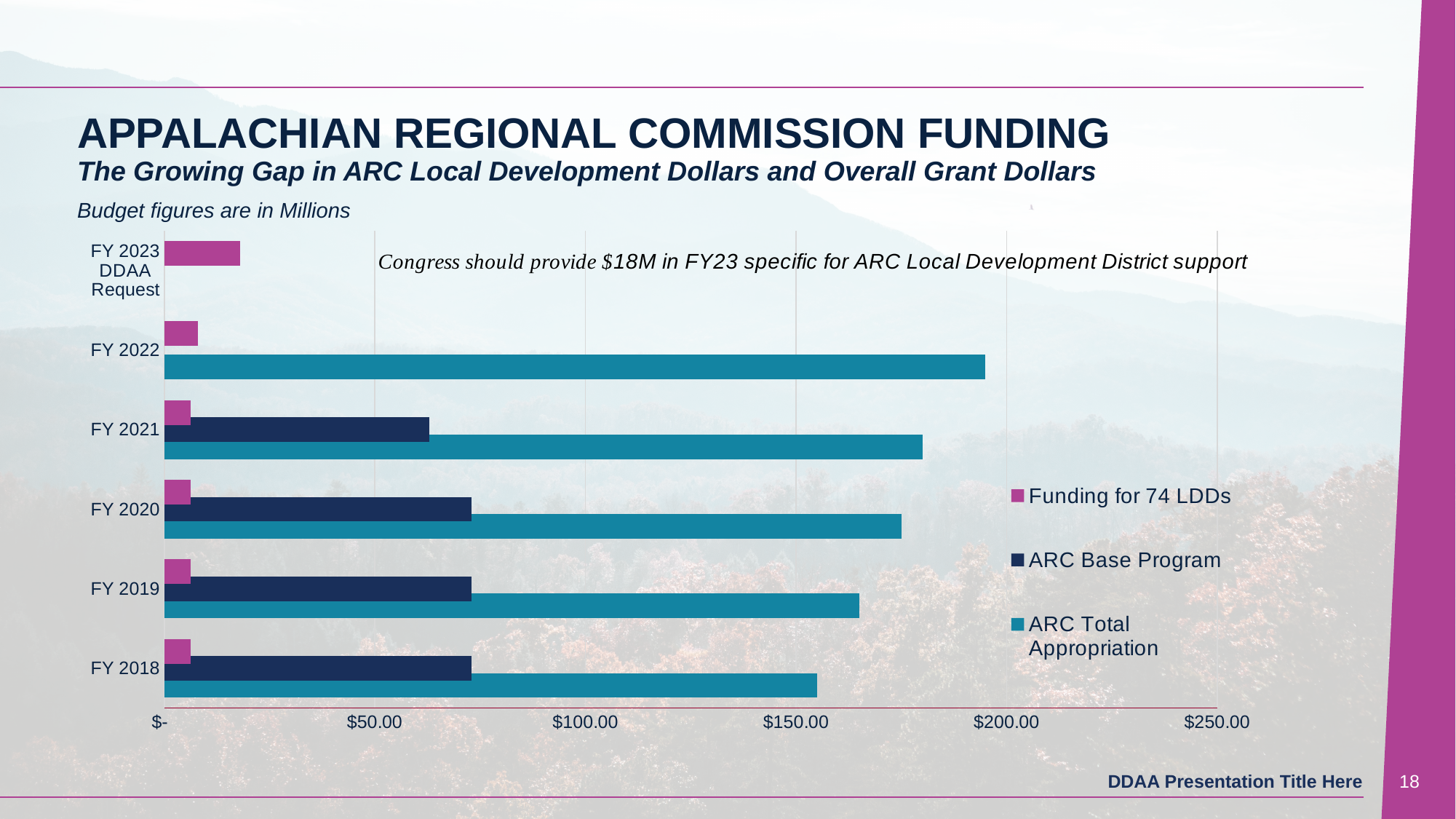
Which is larger, the ARC Base Program value for FY 2020 or for FY 2021? FY 2020 How many series does the chart legend list? 3 Is the ARC Total Appropriation value for FY 2021 greater or less than $150.00? greater Is the ARC Total Appropriation value for FY 2022 greater or less than $200.00? less Is the Funding for 74 LDDs value for the FY 2023 DDAA Request greater or less than $50.00? less Which legend entry is shown in pink? Funding for 74 LDDs Which fiscal year has the highest ARC Total Appropriation bar? FY 2022 Which fiscal year has the lowest ARC Total Appropriation bar? FY 2018 How many fiscal-year categories are shown on the chart's vertical axis? 6 What kind of chart is shown on the slide? bar chart Does the ARC Total Appropriation rise or fall from FY 2018 to FY 2022? rise